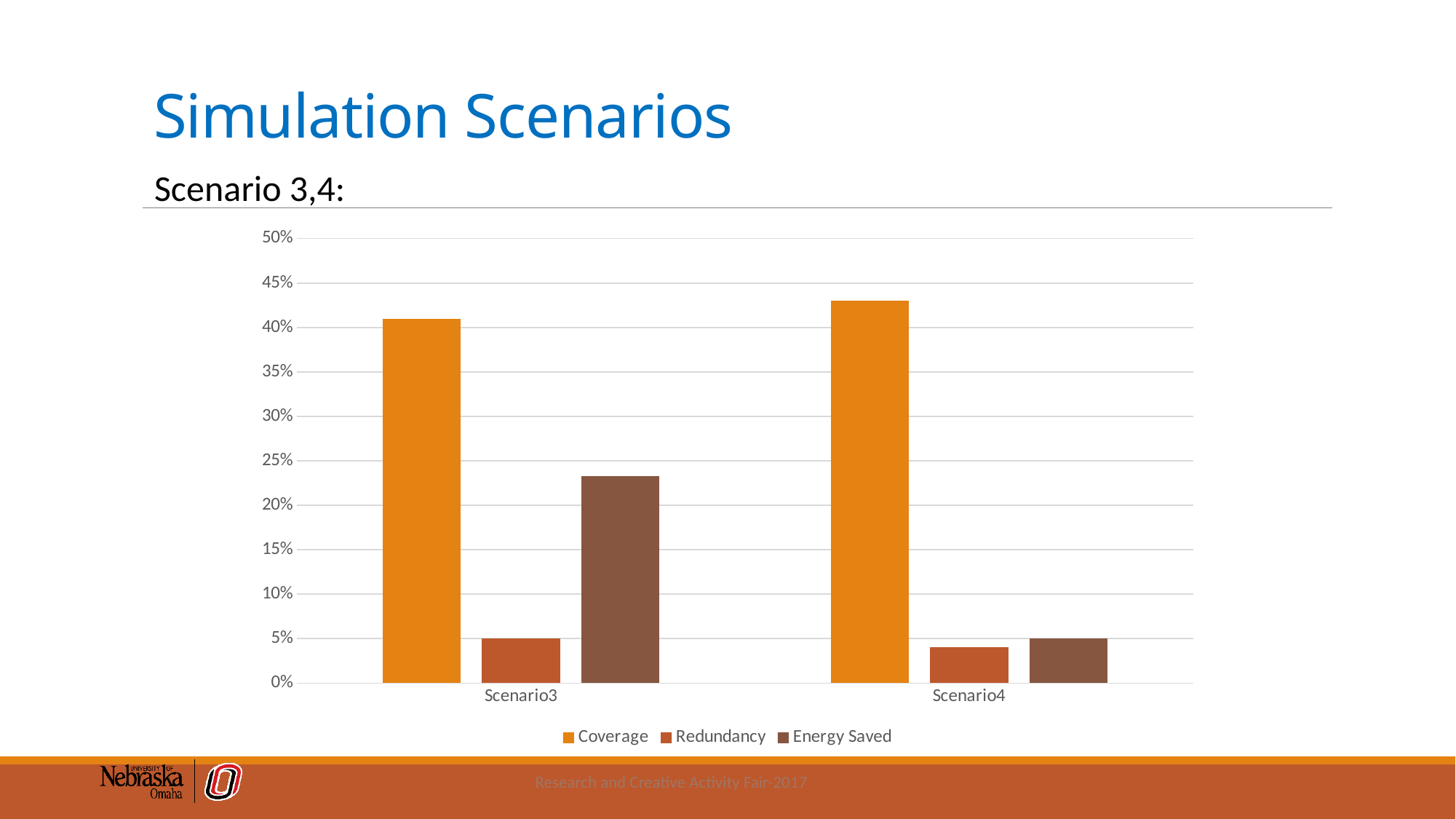
How many series does the legend list? 3 Which series has the lowest value in Scenario3? Redundancy What kind of chart is shown on the slide? bar chart Is the Energy Saved value for Scenario4 greater or less than 10%? less Is the Coverage value for Scenario3 greater or less than 40%? greater Which scenario has the higher Energy Saved value, Scenario3 or Scenario4? Scenario3 Is the Energy Saved value for Scenario3 greater or less than 20%? greater Which series has the highest value in Scenario4? Coverage What are the three series named in the legend? Coverage, Redundancy, Energy Saved How many scenarios (categories) are shown on the x axis? 2 Which scenario has the higher Coverage value, Scenario3 or Scenario4? Scenario4